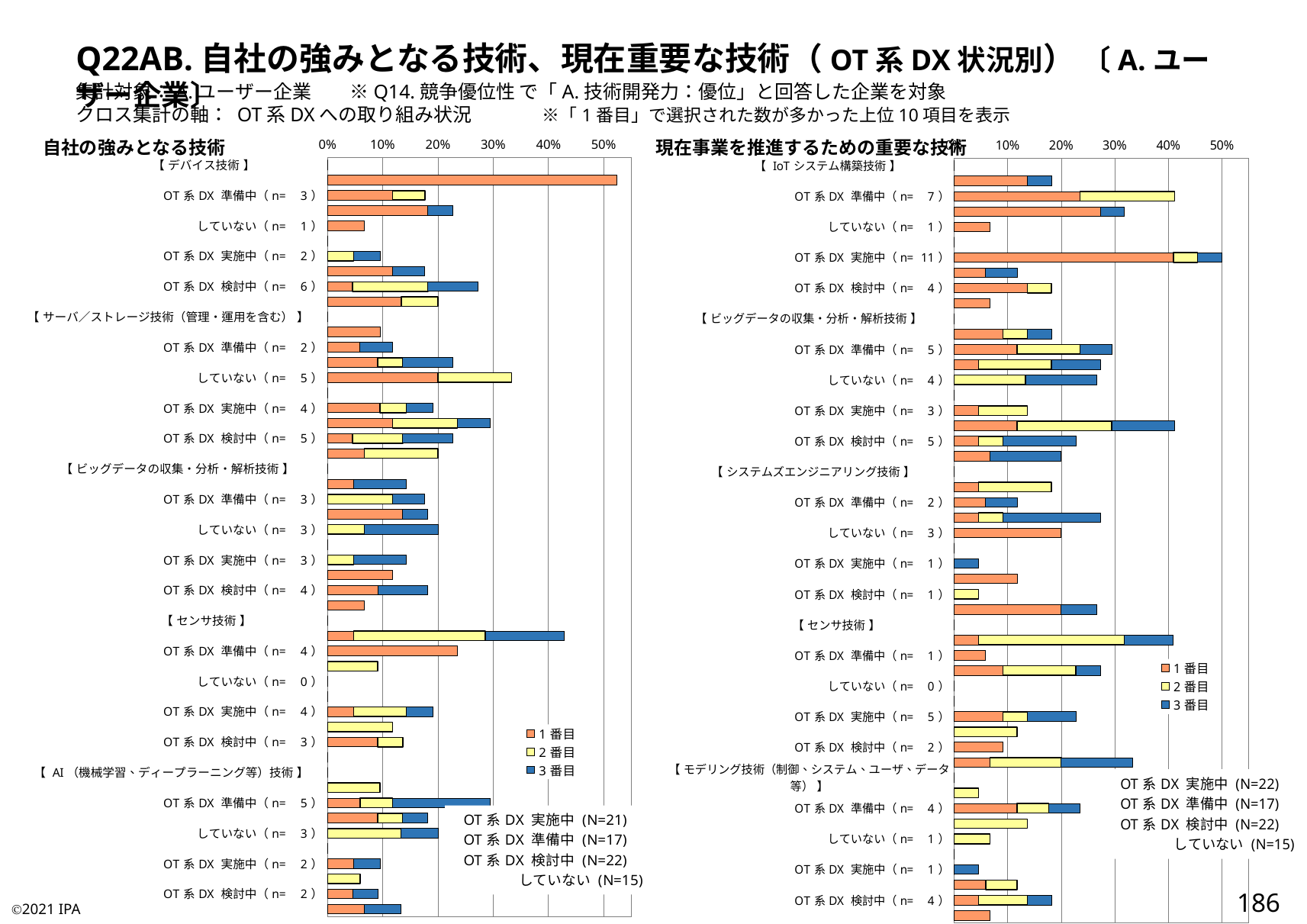
In the left chart 自社の強みとなる技術, is the topmost bar under 【デバイス技術】 greater or less than 50%? greater How many technology category headings (in 【 】) are shown in the right chart 現在事業を推進するための重要な技術? 5 What kind of chart is the right chart titled 現在事業を推進するための重要な技術? bar chart What is the title of the right chart? 現在事業を推進するための重要な技術 How many technology category headings (in 【 】) are shown in the left chart 自社の強みとなる技術? 5 In the left chart 自社の強みとなる技術, is the total of the topmost stacked bar under 【センサ技術】 greater or less than 40%? greater In the right chart 現在事業を推進するための重要な技術, is the total of the topmost stacked bar under 【センサ技術】 greater or less than 30%? greater In the left chart 自社の強みとなる技術, how many series does the legend list? 3 In the right chart 現在事業を推進するための重要な技術, what are the legend entries? 1番目, 2番目, 3番目 What kind of chart is the left chart titled 自社の強みとなる技術? bar chart